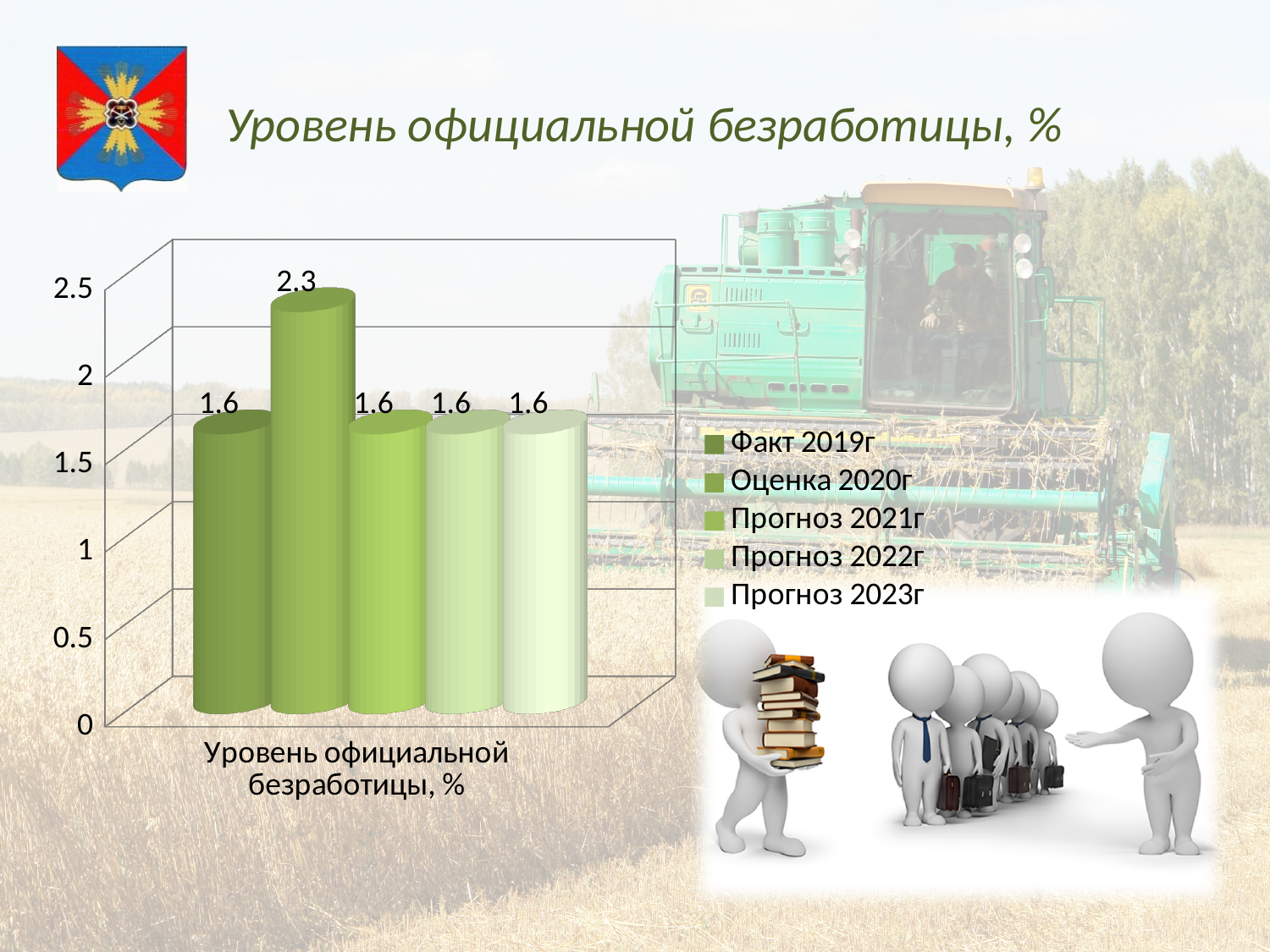
What is the category label shown on the x axis? Уровень официальной безработицы, % Which series has the highest value? Оценка 2020г How many series does the legend list? 5 Is the value for Оценка 2020г greater or less than 2? greater Which is larger, the value for Оценка 2020г or the value for Факт 2019г? Оценка 2020г What is the difference between the values for Оценка 2020г and Прогноз 2021г? 0.7 Is the value for Прогноз 2022г greater or less than 2? less What is the title of the chart? Уровень официальной безработицы, % What is the value for Прогноз 2023г? 1.6 What is the value for Факт 2019г? 1.6 What is the value for Оценка 2020г? 2.3 What kind of chart is shown on the slide? Bar chart